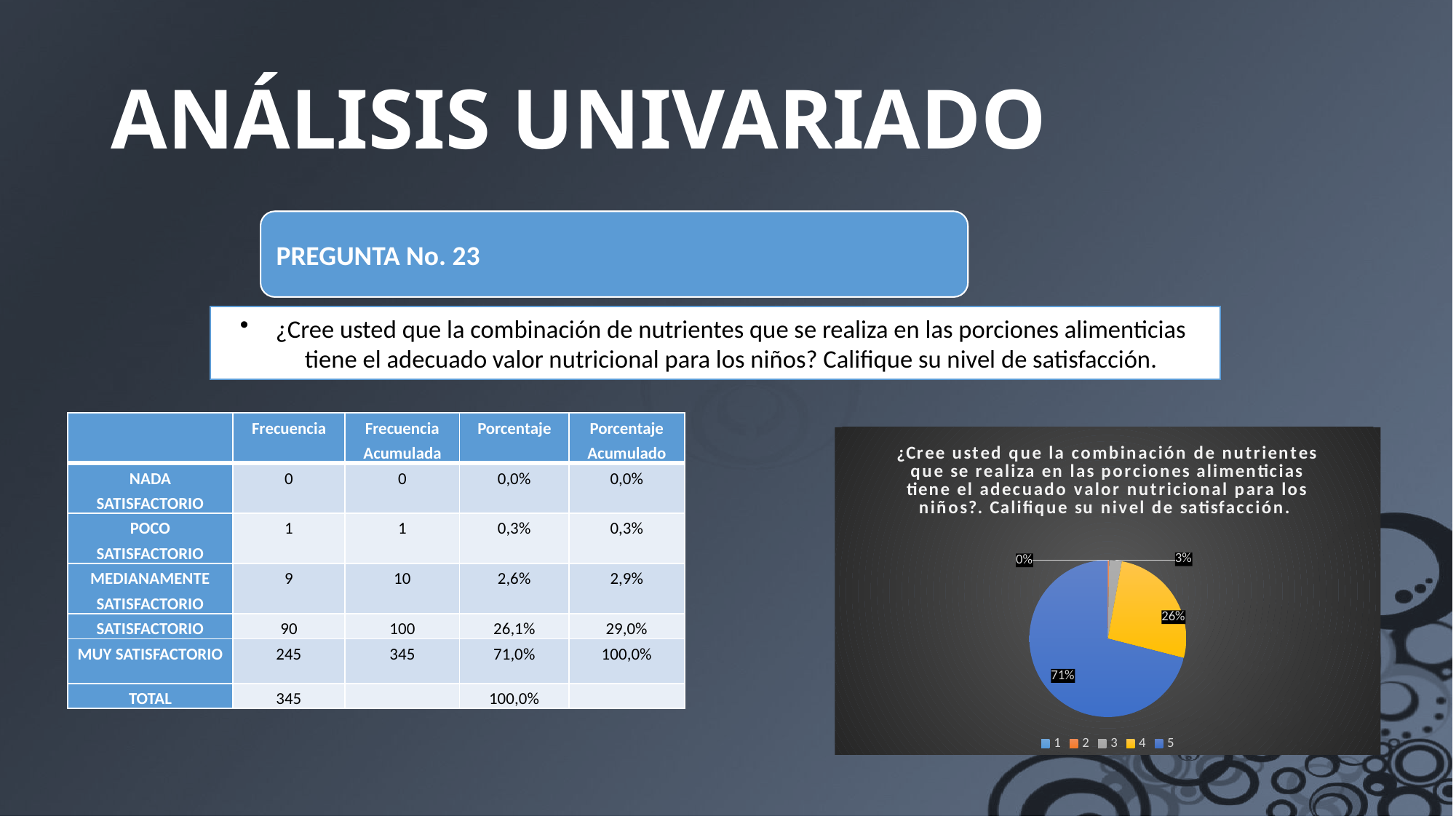
Which slice is larger in the pie chart, the yellow slice (4) or the gray slice (3)? the yellow slice (4) What colour is the largest slice of the pie chart? blue How many entries does the legend of the pie chart list? 5 What kind of chart is shown on the slide? pie chart What percentage is shown on the largest slice of the pie chart? 71% What are the legend entries of the pie chart? 1, 2, 3, 4, 5 What is the difference between the 71% slice and the 26% slice in the pie chart? 45% What percentage is shown on the yellow slice (legend entry 4) of the pie chart? 26% What share of the pie does the blue slice take? 71% What percentage is shown on the gray slice (legend entry 3) of the pie chart? 3% Is the value of the yellow slice in the pie chart greater or less than 50%? less